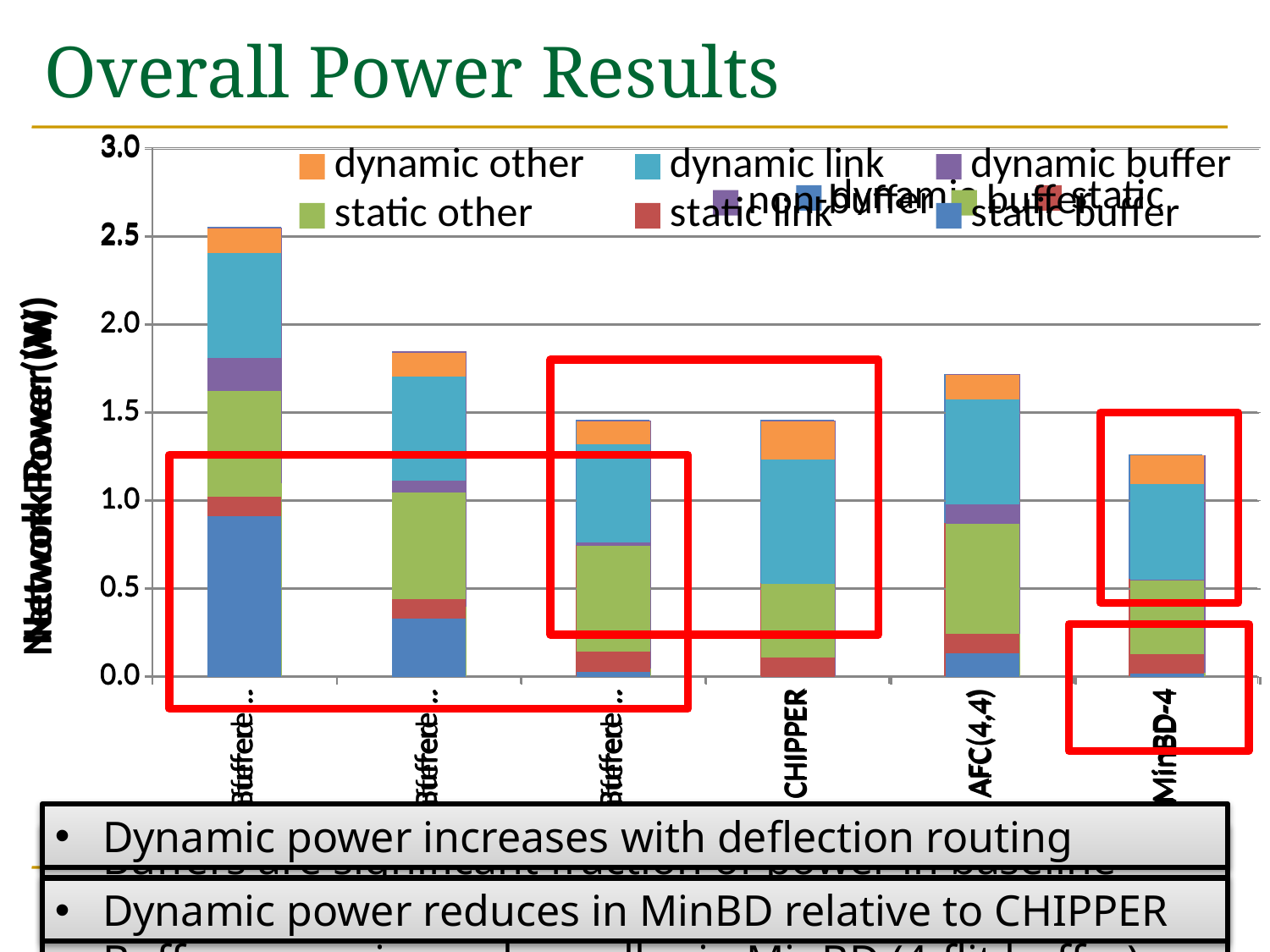
Which has the higher total network power, CHIPPER or AFC(4,4)? AFC(4,4) Which category has the lowest total network power? MinBD-4 Is the total network power for CHIPPER greater or less than 1.0? greater How many bars (categories) are plotted in the chart? 6 Is the total network power for AFC(4,4) greater or less than 1.5? greater What kind of chart is shown on the slide? stacked bar chart Is the total network power for MinBD-4 greater or less than 1.0? greater Which colour represents the 'dynamic other' series in the legend? orange What is the title of the slide's chart? Overall Power Results Which has the higher total network power, AFC(4,4) or MinBD-4? AFC(4,4)